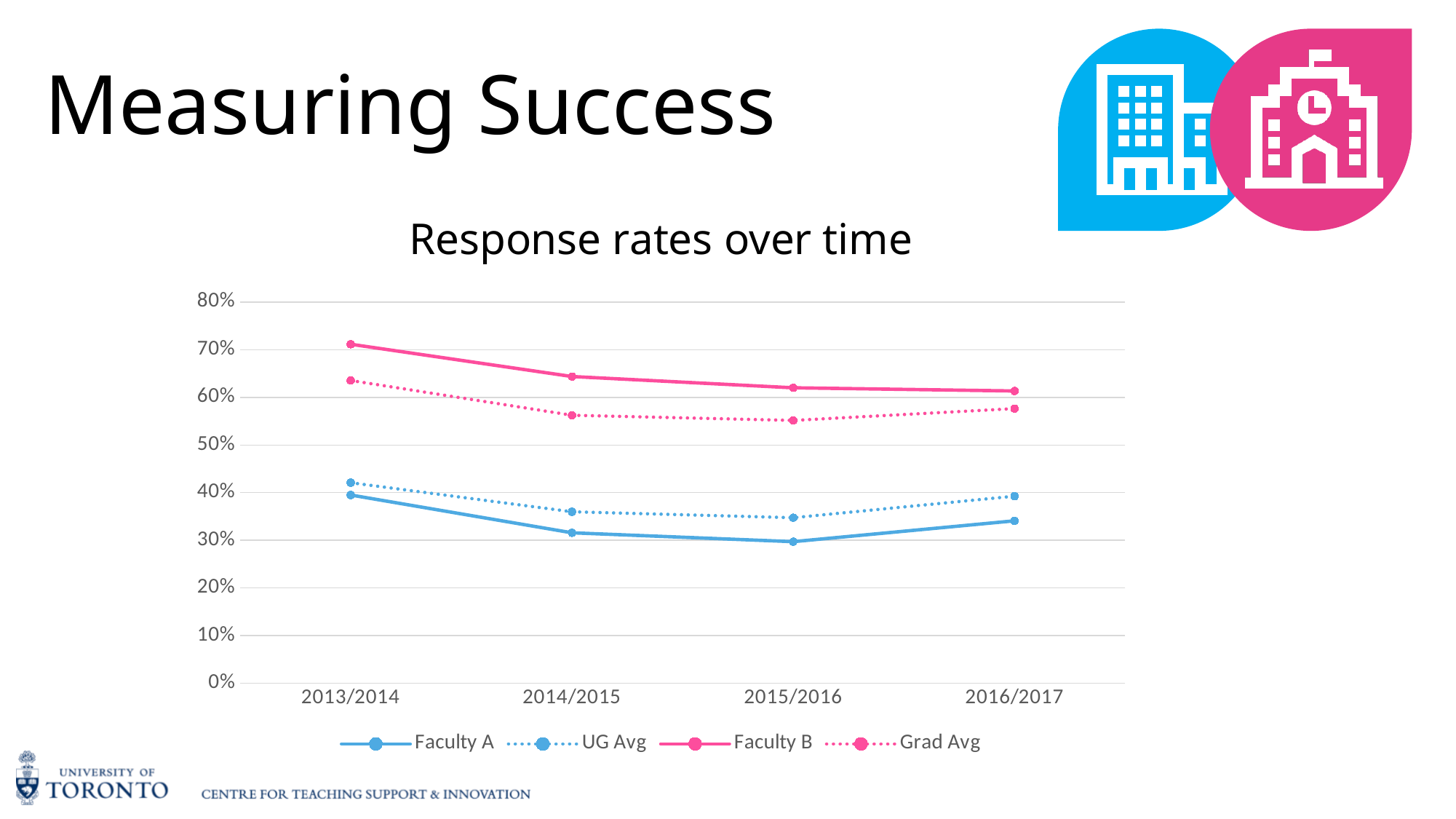
How many series does the legend list? 4 Which series has the lowest value in 2015/2016? Faculty A What kind of chart is shown on the slide? line chart Is the value for Grad Avg in 2014/2015 greater or less than 60%? less Which series are drawn with dotted lines? UG Avg and Grad Avg What is the title of the chart? Response rates over time Is the value for Faculty A in 2015/2016 greater or less than 40%? less Does the Faculty B line rise or fall from 2013/2014 to 2016/2017? fall Is the value for Faculty B in 2013/2014 greater or less than 60%? greater Which series has the highest value in 2013/2014? Faculty B Which is larger in 2016/2017, Faculty A or Faculty B? Faculty B How many academic years are plotted along the x axis? 4